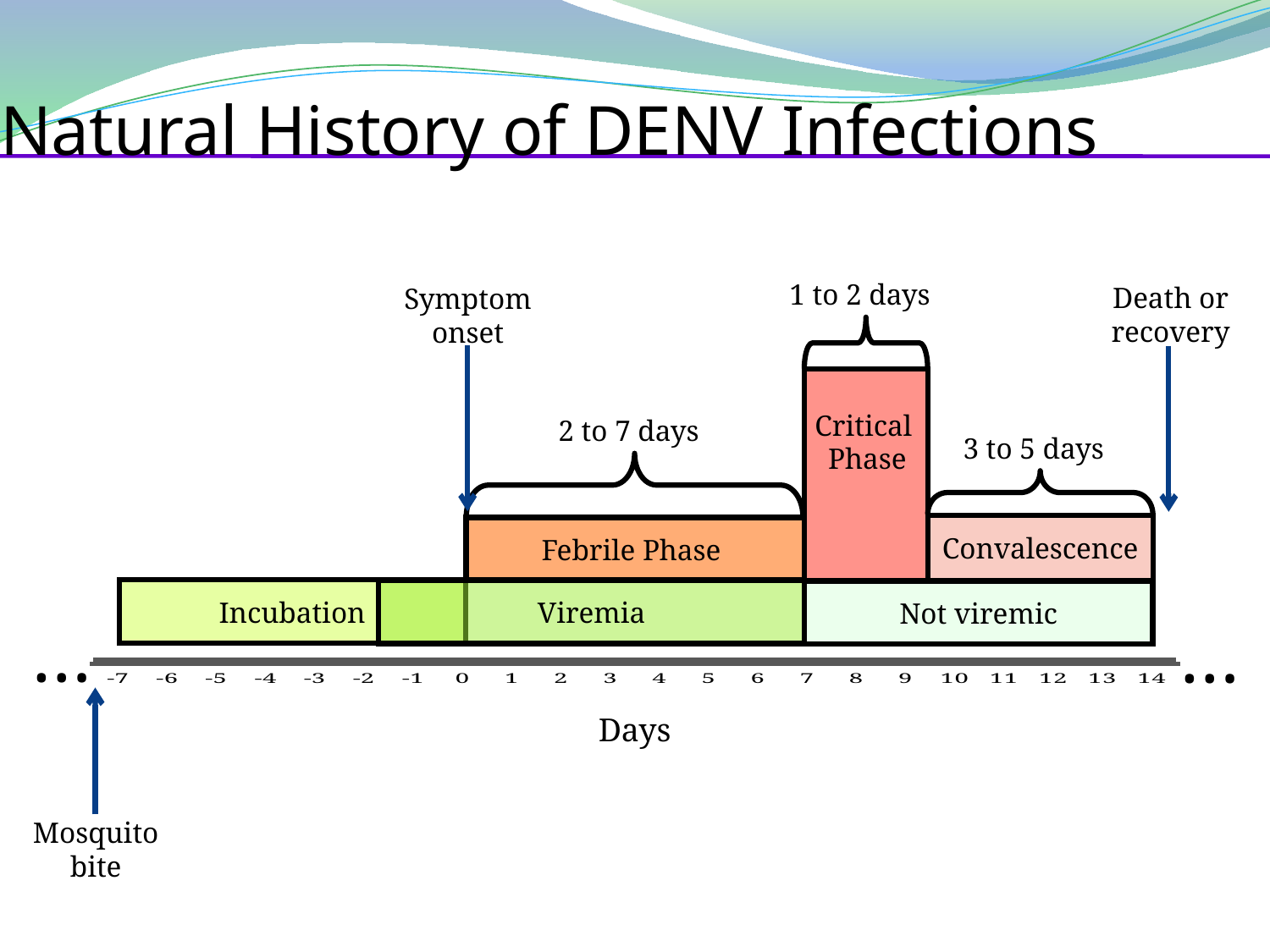
On which day of the axis does symptom onset occur? 0 What is the title of the diagram on the slide? Natural History of DENV Infections On which day of the axis does the mosquito bite occur? -7 How many clinical phases (Febrile Phase, Critical Phase, Convalescence) are shown in the upper row of blocks? 3 On which day of the axis is death or recovery marked? 14 How long does Convalescence last according to the label above it? 3 to 5 days How long does the Febrile Phase last according to the label above it? 2 to 7 days What is the label of the horizontal axis? Days Which labeled phase has the longest stated maximum duration? Febrile Phase How long does the Critical Phase last according to the label above it? 1 to 2 days Which labeled phase has the shortest stated duration? Critical Phase Which occurs earlier on the timeline, the Febrile Phase or Convalescence? Febrile Phase